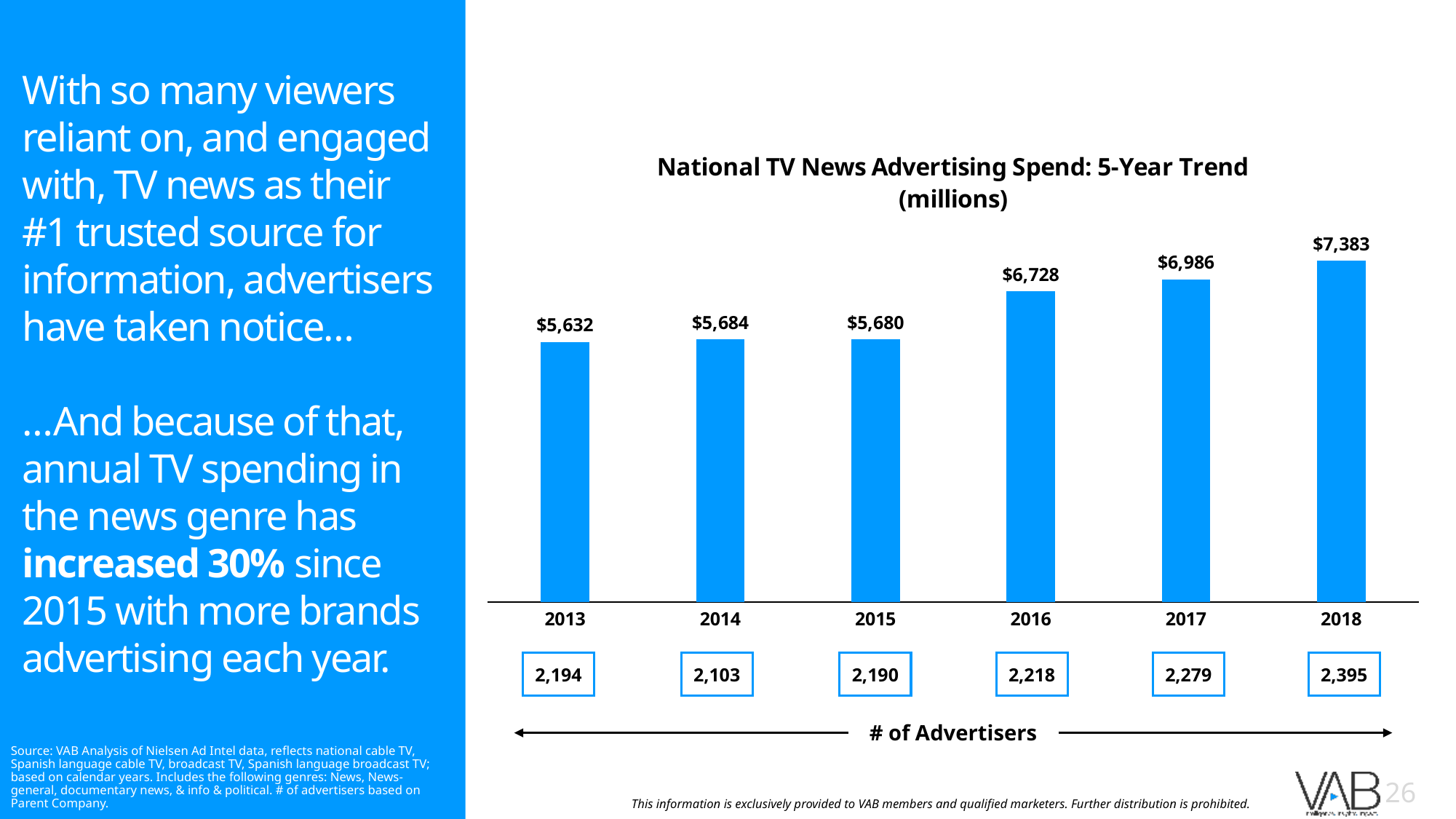
Which year has the lowest National TV News Advertising Spend? 2013 What is the National TV News Advertising Spend for 2016? $6,728 Which year has the highest National TV News Advertising Spend? 2018 Does the advertising spend generally rise or fall from 2015 to 2018? Rise What kind of chart is used to show the National TV News Advertising Spend? Bar chart How many years are shown in the National TV News Advertising Spend chart? 6 What is the National TV News Advertising Spend for 2013? $5,632 What is the difference in advertising spend between 2017 and 2016? $258 Which year has a larger advertising spend, 2016 or 2014? 2016 What is the difference in advertising spend between 2018 and 2015? $1,703 What is the National TV News Advertising Spend for 2018? $7,383 What is the title of the chart on the slide? National TV News Advertising Spend: 5-Year Trend (millions)